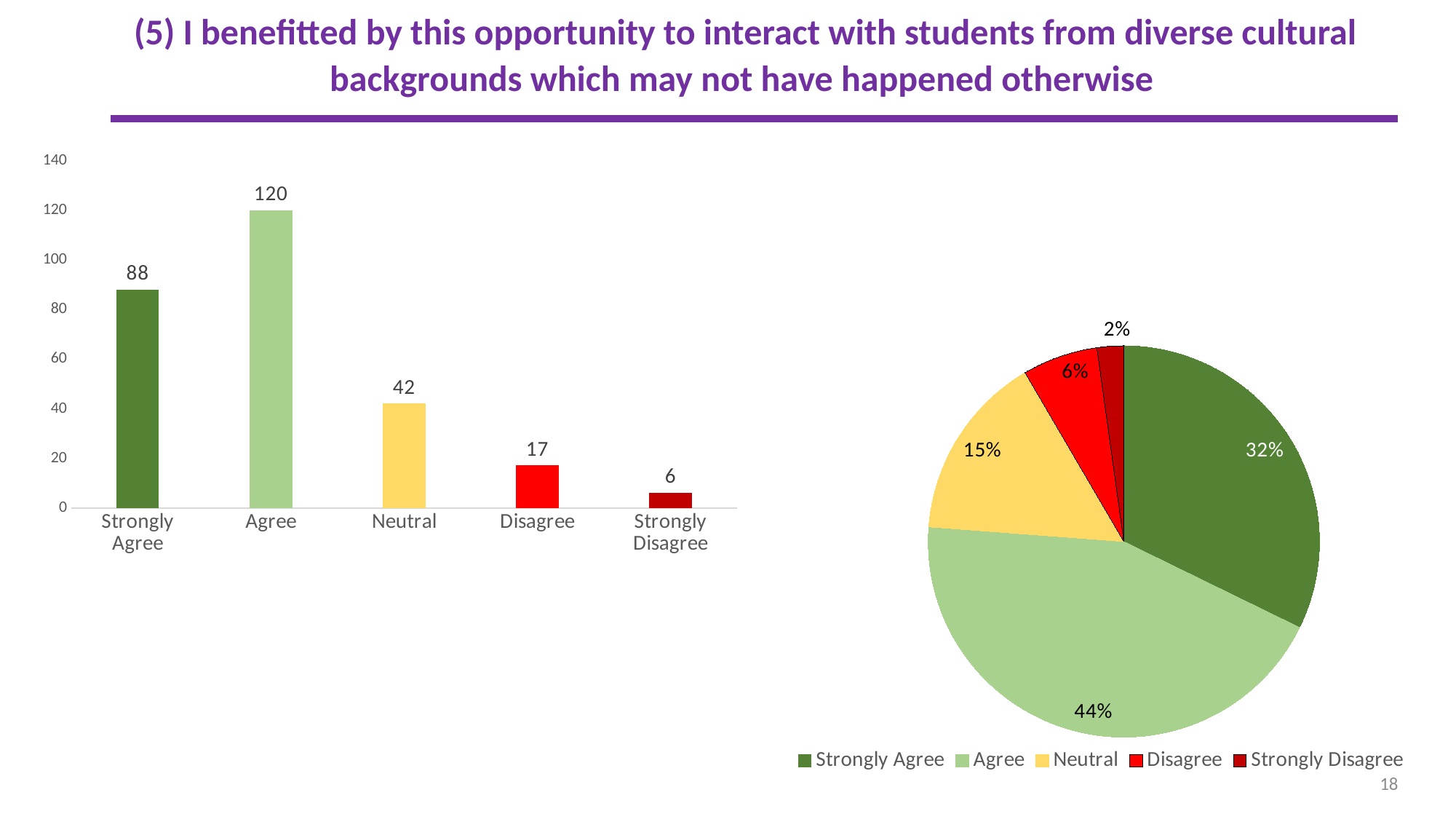
In the pie chart on the right, how many entries does the legend list? 5 In the bar chart on the left, which category has the highest value? Agree In the pie chart on the right, what share does Agree have? 44% What kind of chart is on the left of the slide? Bar chart In the bar chart on the left, how many categories are shown? 5 In the pie chart on the right, what share does Strongly Disagree have? 2% What kind of chart is on the right of the slide? Pie chart In the bar chart on the left, what is the value for Agree? 120 In the bar chart on the left, which is larger, the value for Disagree or the value for Neutral? Neutral In the bar chart on the left, what is the value for Neutral? 42 In the bar chart on the left, which category has the lowest value? Strongly Disagree In the bar chart on the left, what is the difference between the values for Agree and Strongly Agree? 32